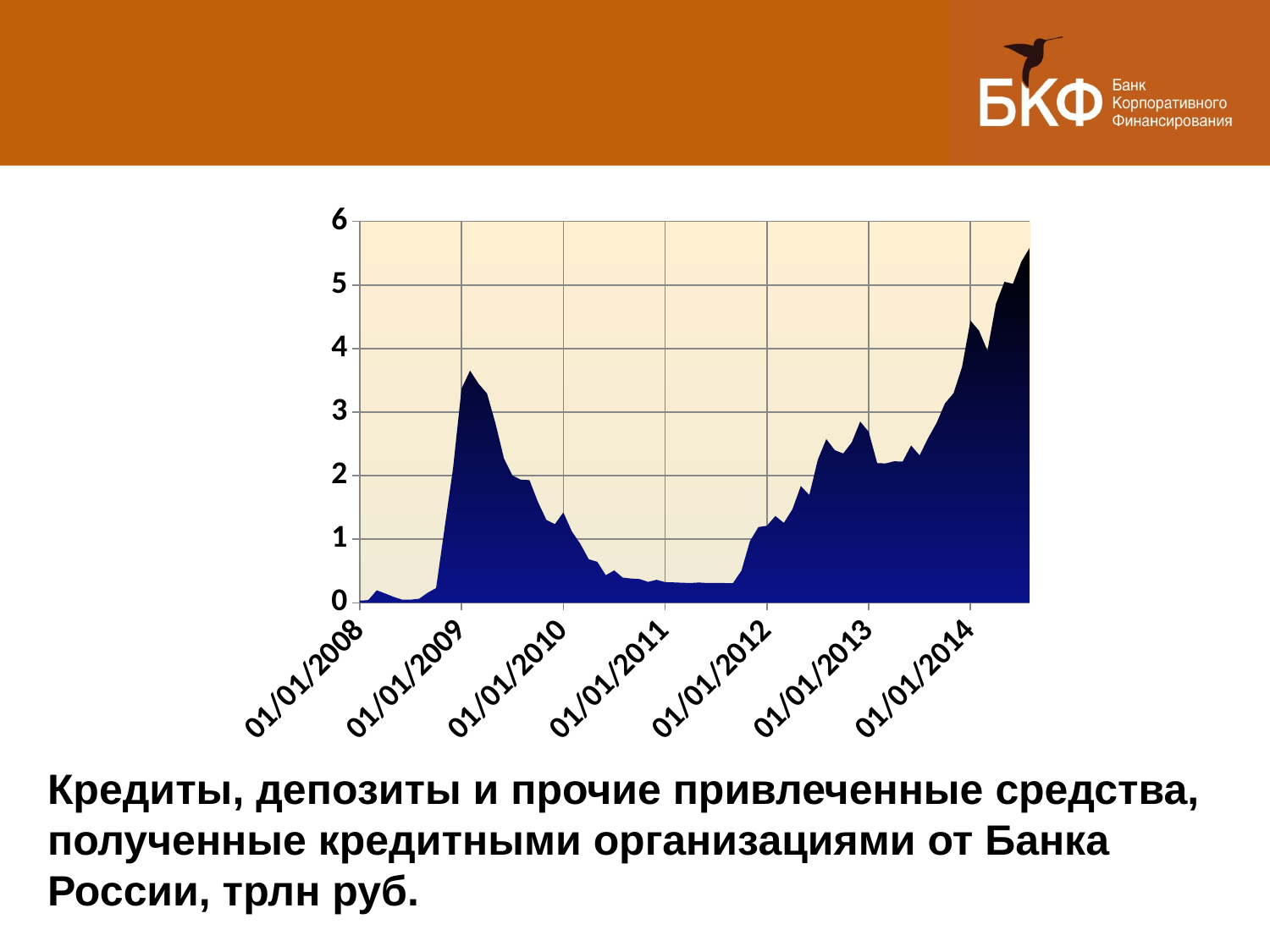
In what units are the values on the chart expressed, according to the caption? трлн руб. What kind of chart is shown on the slide? area chart Is the value at 01/01/2008 greater or less than 1? less Do the values rise or fall between 01/01/2012 and 01/01/2014? rise Which of the labelled dates on the x axis has the lowest value? 01/01/2008 How many dates are labelled on the x axis of the chart? 7 Is the value at 01/01/2011 greater or less than 1? less Do the values rise or fall between 01/01/2009 and 01/01/2011? fall Which of the labelled dates has the highest value: 01/01/2009 or 01/01/2014? 01/01/2014 Is the value at 01/01/2013 greater or less than 2? greater